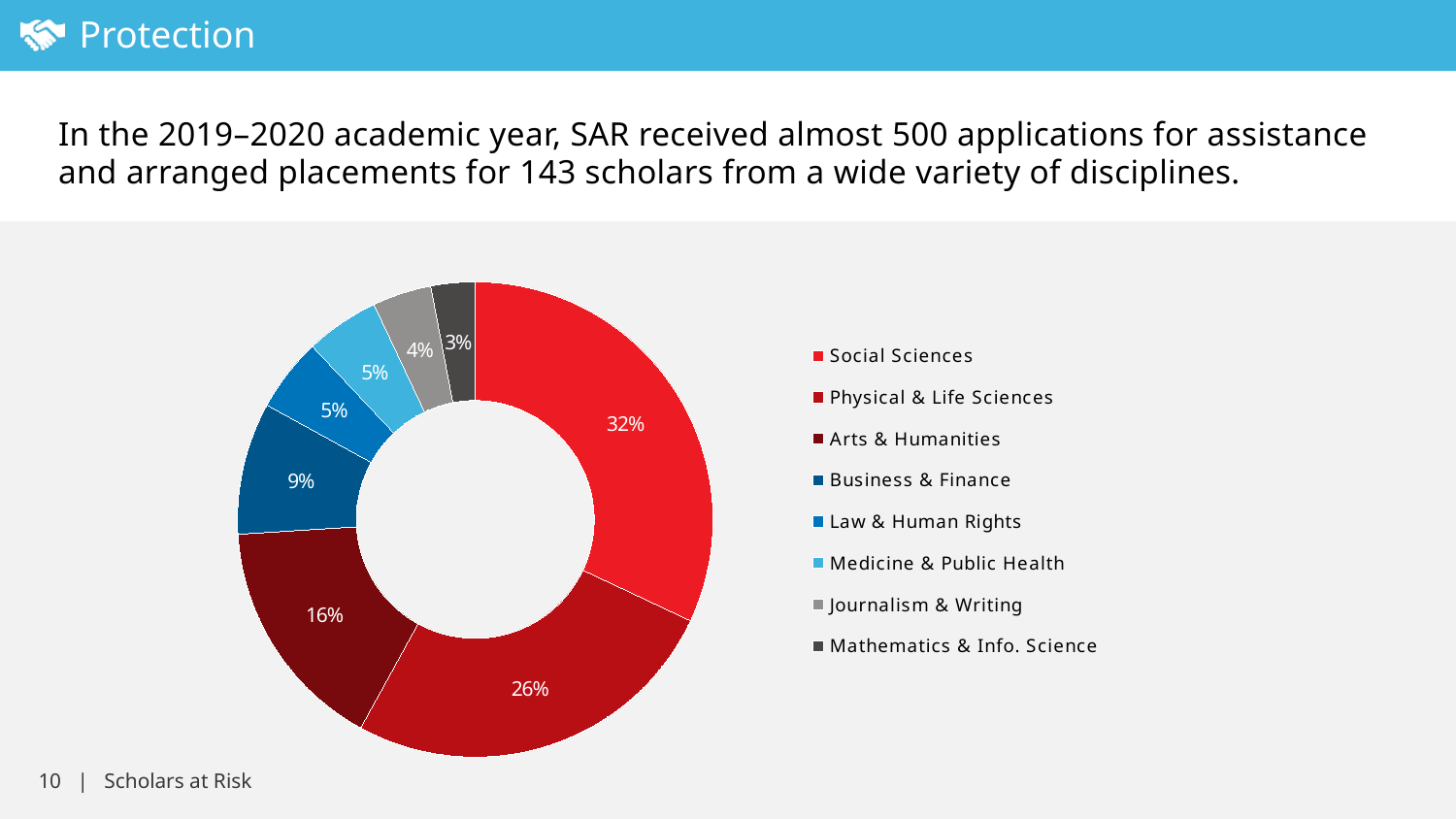
What share does Physical & Life Sciences have in the pie chart? 26% What percentage is shown for Arts & Humanities? 16% What type of chart is shown on the slide? doughnut chart How many disciplines are listed in the chart legend? 8 What percentage is shown for Mathematics & Info. Science? 3% Which has a larger share, Business & Finance or Journalism & Writing? Business & Finance What percentage is shown for Business & Finance? 9% What percentage of the pie chart is Social Sciences? 32% What colour is the Social Sciences slice in the chart? red What is the difference in percentage points between Social Sciences and Physical & Life Sciences? 6 Which discipline has the smallest share of the pie chart? Mathematics & Info. Science Which discipline has the largest share of the pie chart? Social Sciences